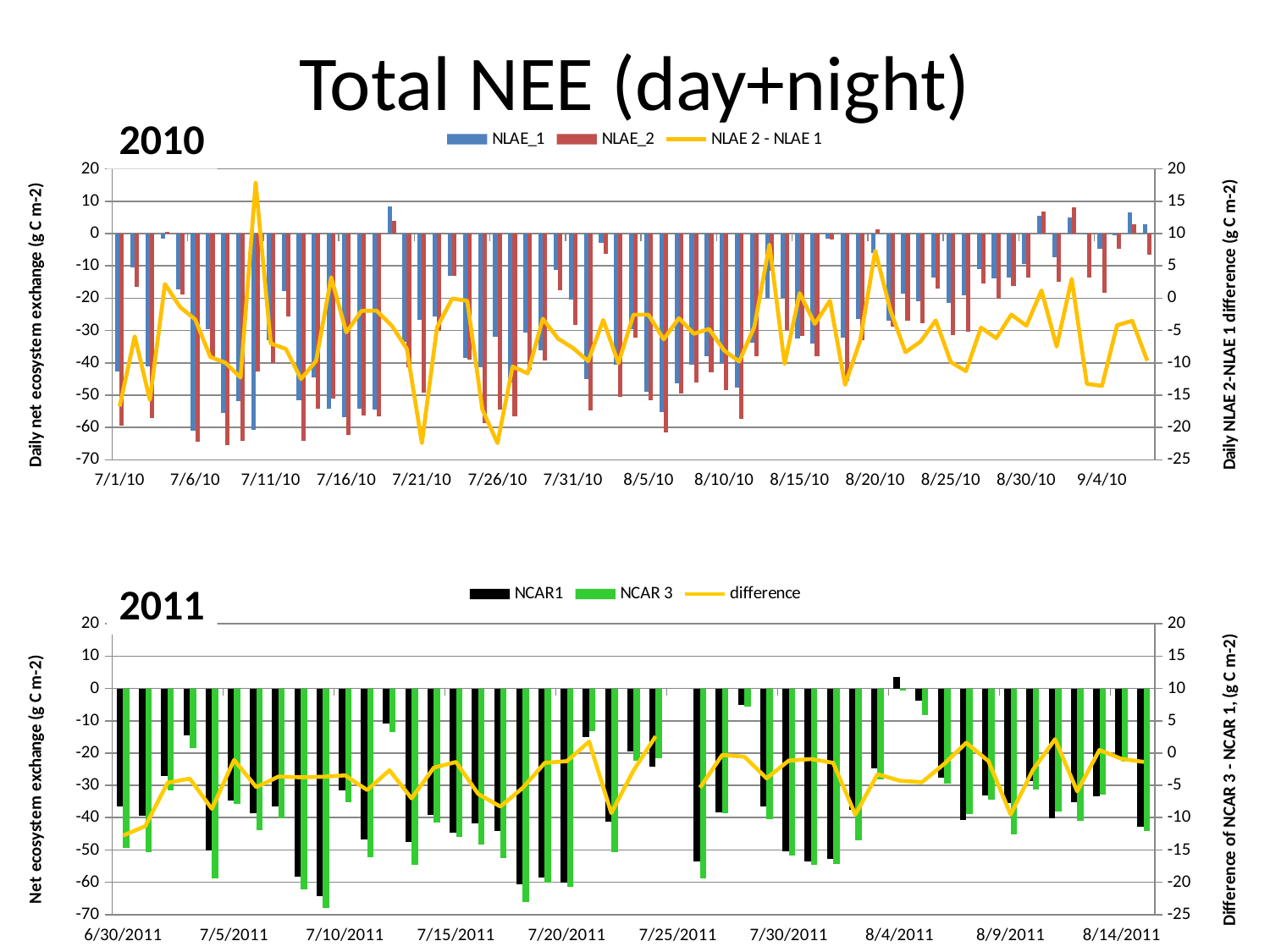
What kind of chart is the 2011 chart at the bottom of the slide? Bar chart with a line What are the three legend entries of the 2011 chart? NCAR1, NCAR 3, difference How many series does the legend of the 2010 chart list? 3 How many series does the legend of the 2011 chart list? 3 What kind of chart is the 2010 chart at the top of the slide? Bar chart with a line In the 2011 chart, which is larger on 6/30/2011, the NCAR1 value or the NCAR 3 value? NCAR1 In the 2011 chart, is the NCAR1 value on 6/30/2011 greater or less than -30? less In the 2010 chart, do the NLAE_1 bars generally rise or fall from 7/1/10 to 9/4/10? rise What colour are the NLAE_2 bars in the 2010 chart? Red In the 2011 chart, is the NCAR 3 value on 6/30/2011 greater or less than -40? less In the 2010 chart, is the NLAE_1 value on 7/6/10 greater or less than -40? less